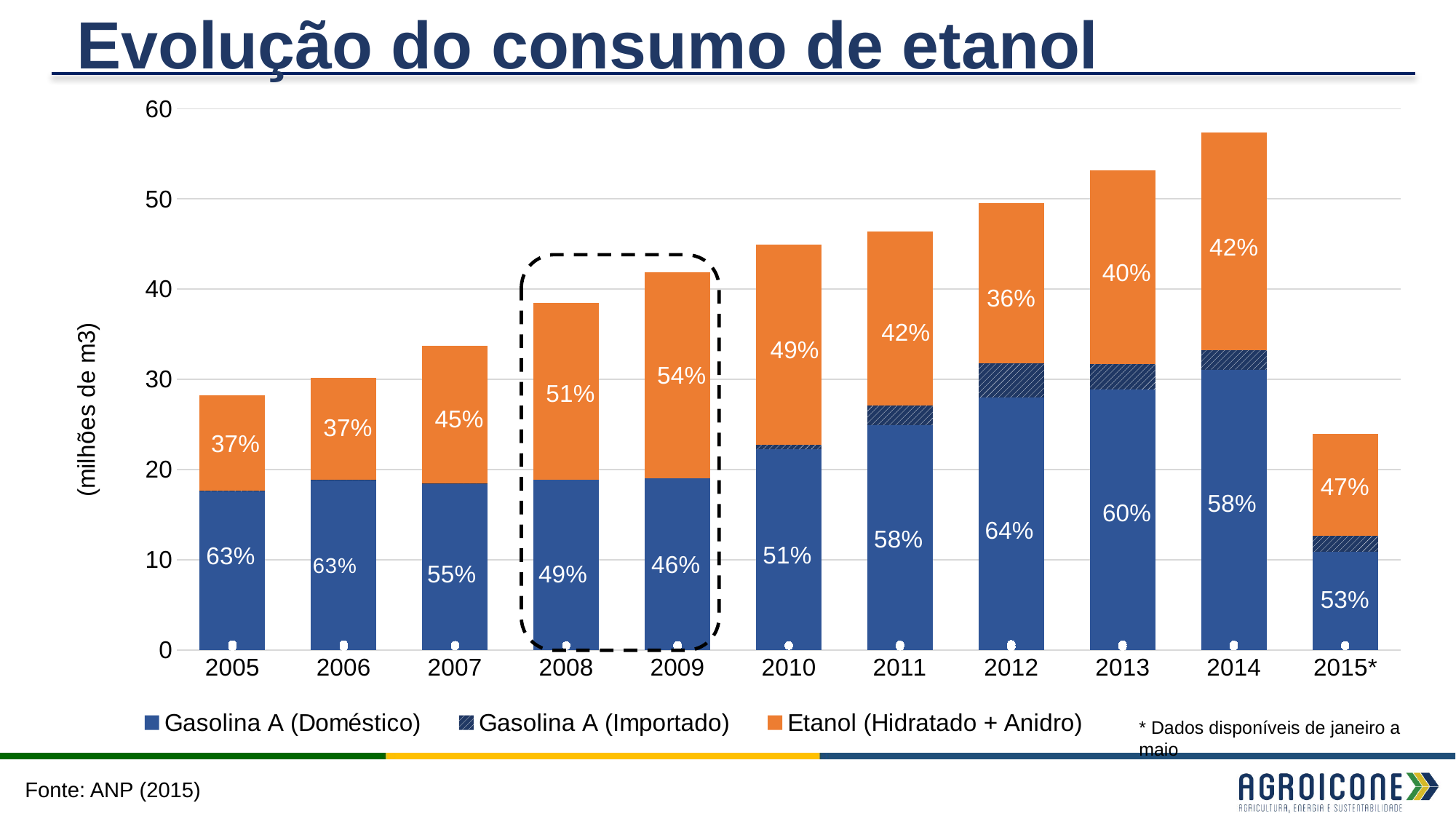
How many series does the legend list? 3 What percentage share does Etanol (Hidratado + Anidro) have in 2015*? 47% What percentage share does Etanol (Hidratado + Anidro) have in 2009? 54% In which year is the Etanol (Hidratado + Anidro) share label the lowest? 2012 What kind of chart is shown on the slide? Stacked bar chart Is the total bar for 2005 greater or less than 30 milhões de m3? less Which year has the shortest total bar? 2015* What percentage share does Gasolina A (Doméstico) have in 2012? 64% In which year is the Etanol (Hidratado + Anidro) share label the highest? 2009 Which year has the tallest total bar? 2014 Is the total bar for 2014 greater or less than 50 milhões de m3? greater How many years are shown on the x axis? 11